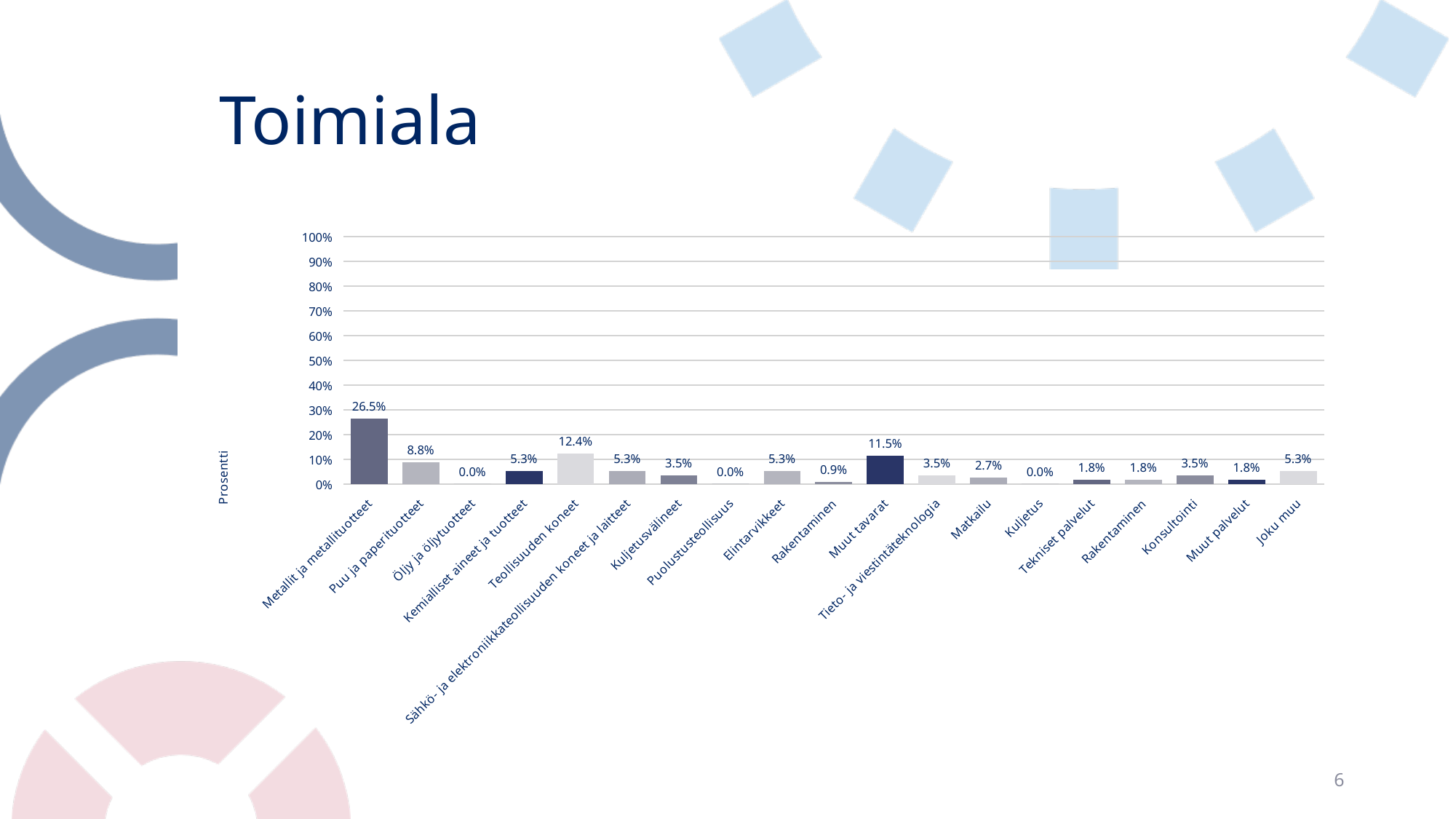
What is the difference between the values for Metallit ja metallituotteet and Teollisuuden koneet? 14.1% Which category has the highest value? Metallit ja metallituotteet What is the value for Muut tavarat? 11.5% Which is larger, the value for Puu ja paperituotteet or the value for Muut tavarat? Muut tavarat What is the value for Matkailu? 2.7% What is the value for Metallit ja metallituotteet? 26.5% Is the value for Metallit ja metallituotteet greater or less than 20%? greater What is the title of the slide containing the chart? Toimiala How many categories are shown on the x axis of the chart? 19 What is the label on the vertical axis of the chart? Prosentti What is the value for Teollisuuden koneet? 12.4% What type of chart is shown on the slide? bar chart